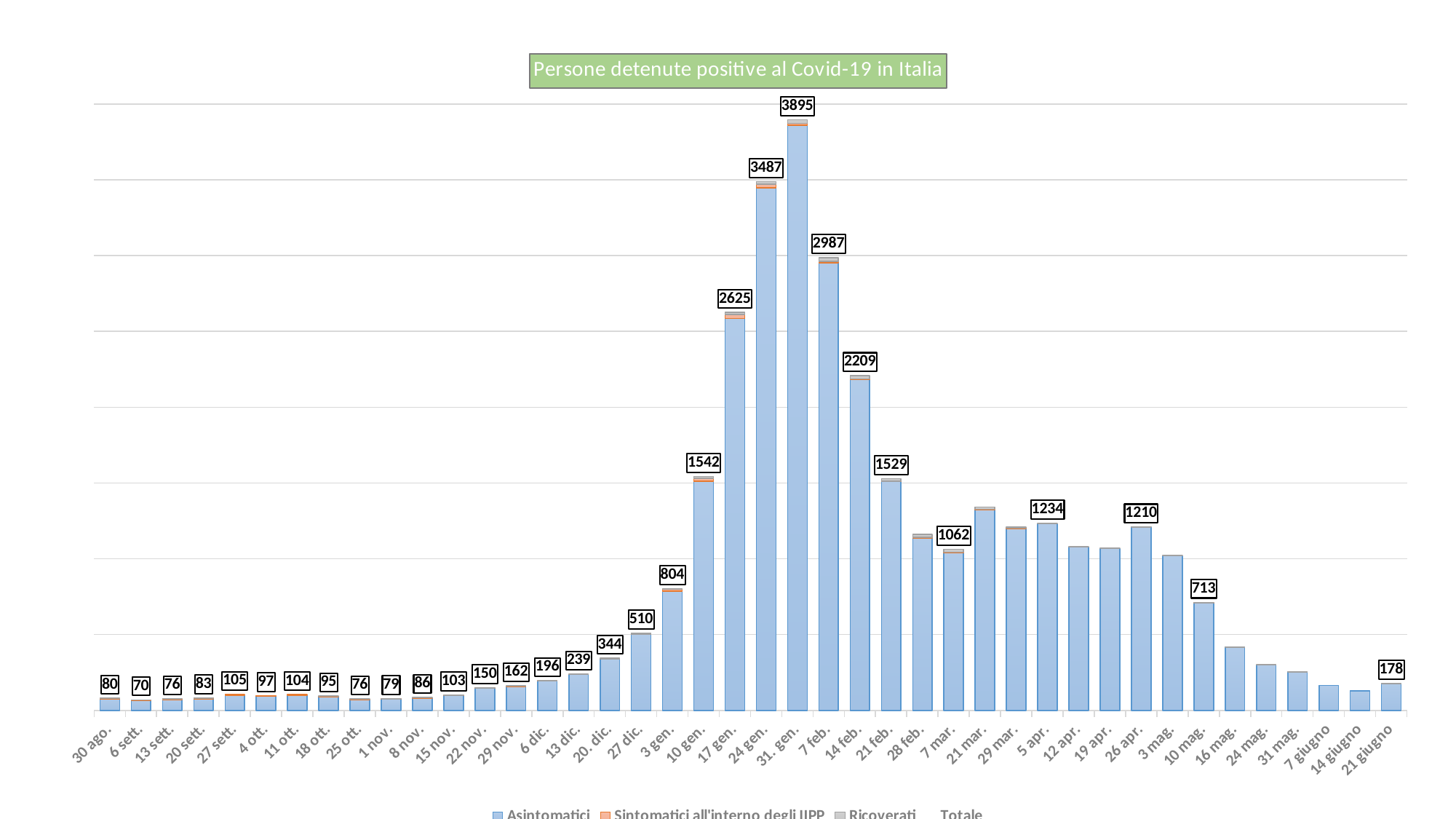
What is the total value labelled for 21 giugno? 178 What is the difference between the totals for 5 apr. and 26 apr.? 24 Which date has the highest total? 31 gen. Which date has the lowest total? 6 sett. What is the title of the chart? Persone detenute positive al Covid-19 in Italia Which is larger, the total for 24 gen. or the total for 7 feb.? 24 gen. What is the difference between the totals for 31 gen. and 24 gen.? 408 What is the total value labelled for 10 gen.? 1542 How many series does the legend list? 4 What type of chart is shown on the slide? bar chart Do the totals rise or fall from 31 gen. to 21 giugno? fall What is the total value labelled for 31 gen.? 3895